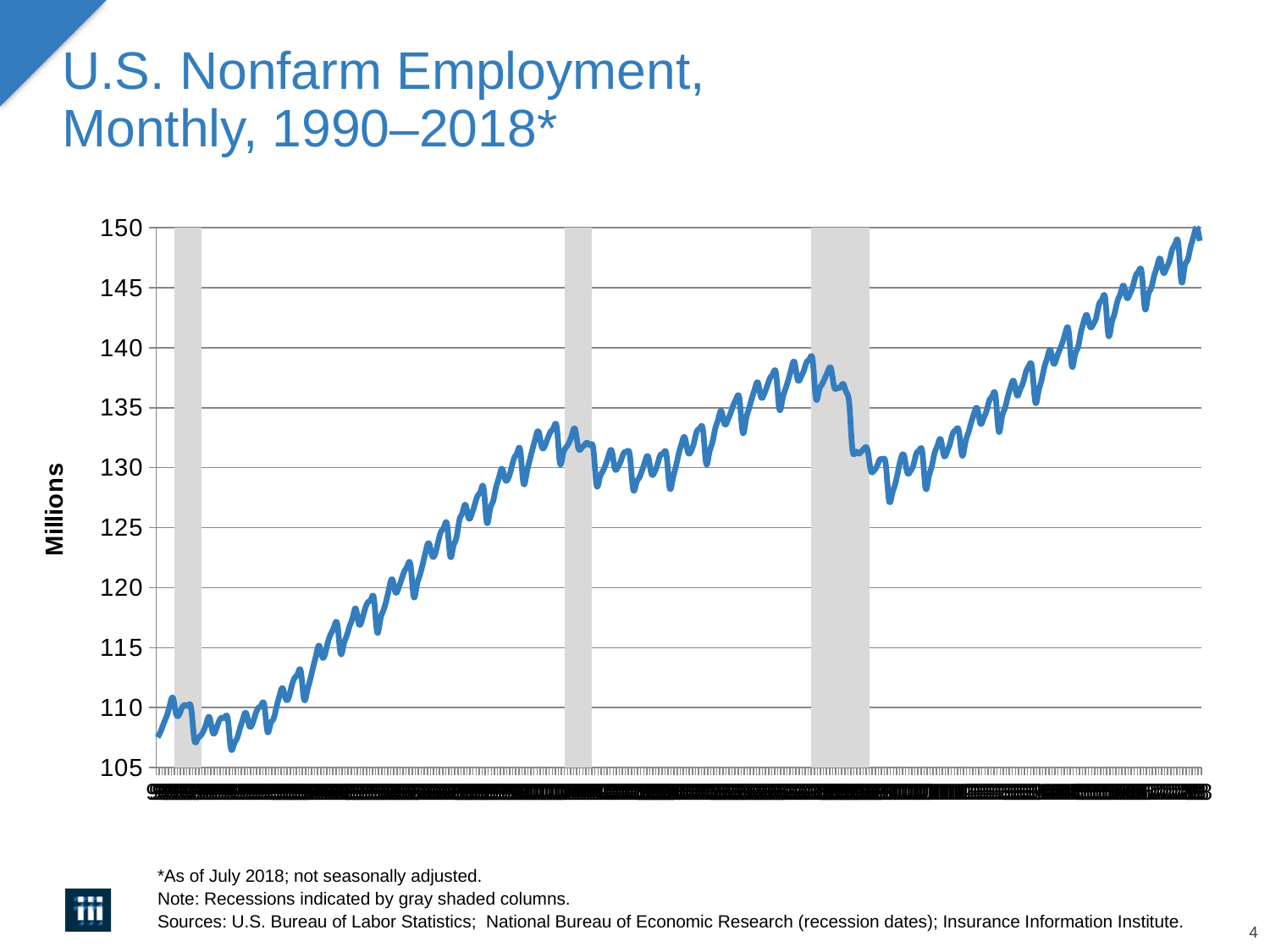
Is the highest value reached by the line greater or less than 140? greater What kind of chart is shown on the slide? line chart What is the highest value shown on the vertical axis of the chart? 150 Is the value at the rightmost point of the line greater or less than 145? greater What is the title of the chart on the slide? U.S. Nonfarm Employment, Monthly, 1990–2018* Is the value at the lowest point of the line just after the third gray shaded column greater or less than 130? less Which is larger: the value at the rightmost point of the line or the value at the leftmost point? the rightmost point Overall, does the line rise or fall from the left of the chart to the right? rise What is the label on the vertical axis of the chart? Millions